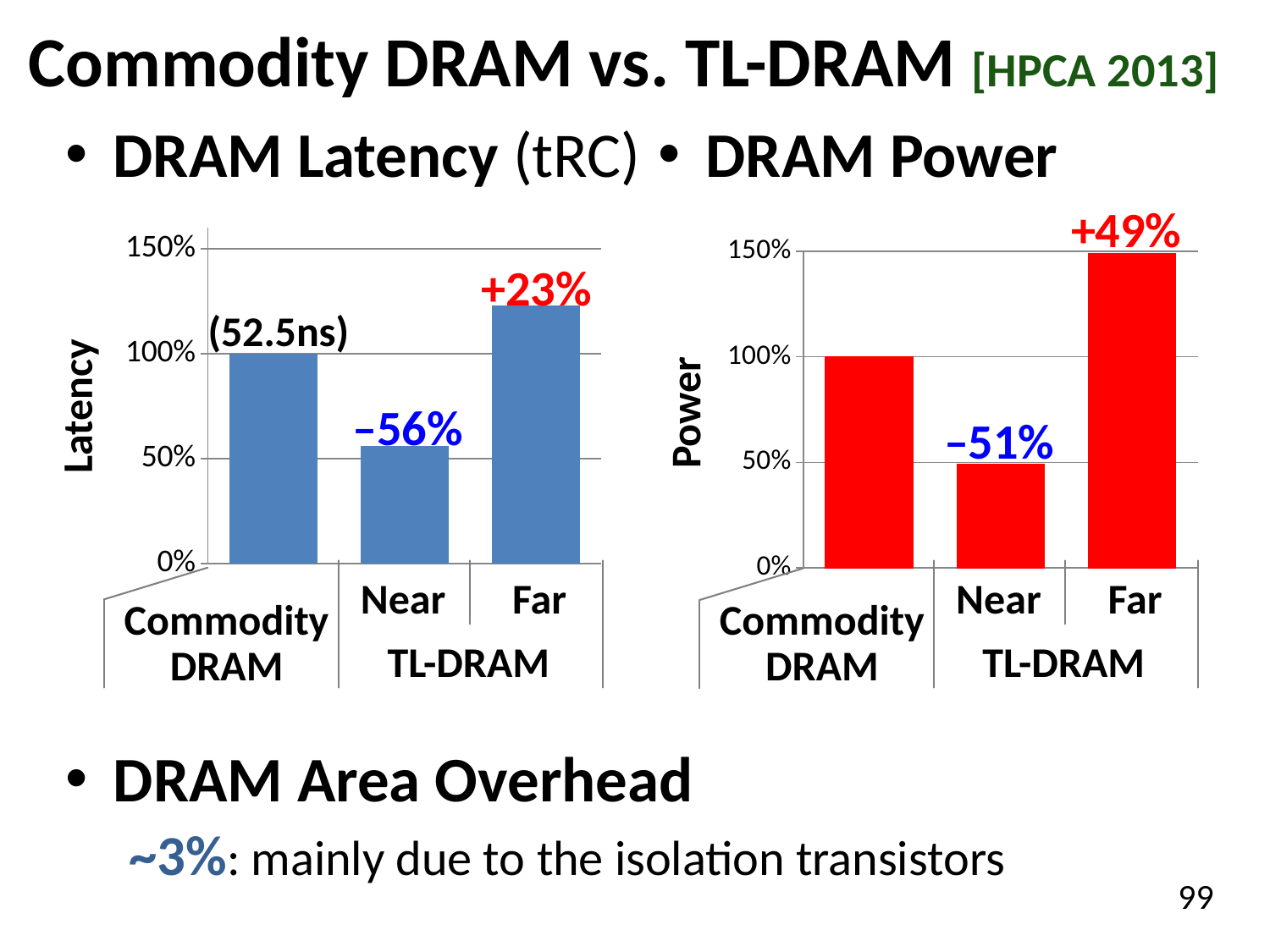
How many bars does the DRAM Power chart have? 3 In the DRAM Latency chart, what change is labeled above the Near bar? –56% What kind of chart is the DRAM Latency chart on the left? bar chart In the DRAM Latency chart, what is the value for Commodity DRAM? 100% In the DRAM Power chart, what change is labeled above the Far bar? +49% In the DRAM Latency chart, what change is labeled above the Far bar? +23% In the DRAM Power chart, is the value for Far greater or less than 100%? greater In the DRAM Power chart, what change is labeled above the Near bar? –51% In the DRAM Latency chart, which bar is the lowest? Near In the DRAM Latency chart, is the value for Near greater or less than 50%? greater In the DRAM Power chart, which bar is the highest? Far In the DRAM Latency chart, what absolute latency is printed next to the Commodity DRAM bar? 52.5ns